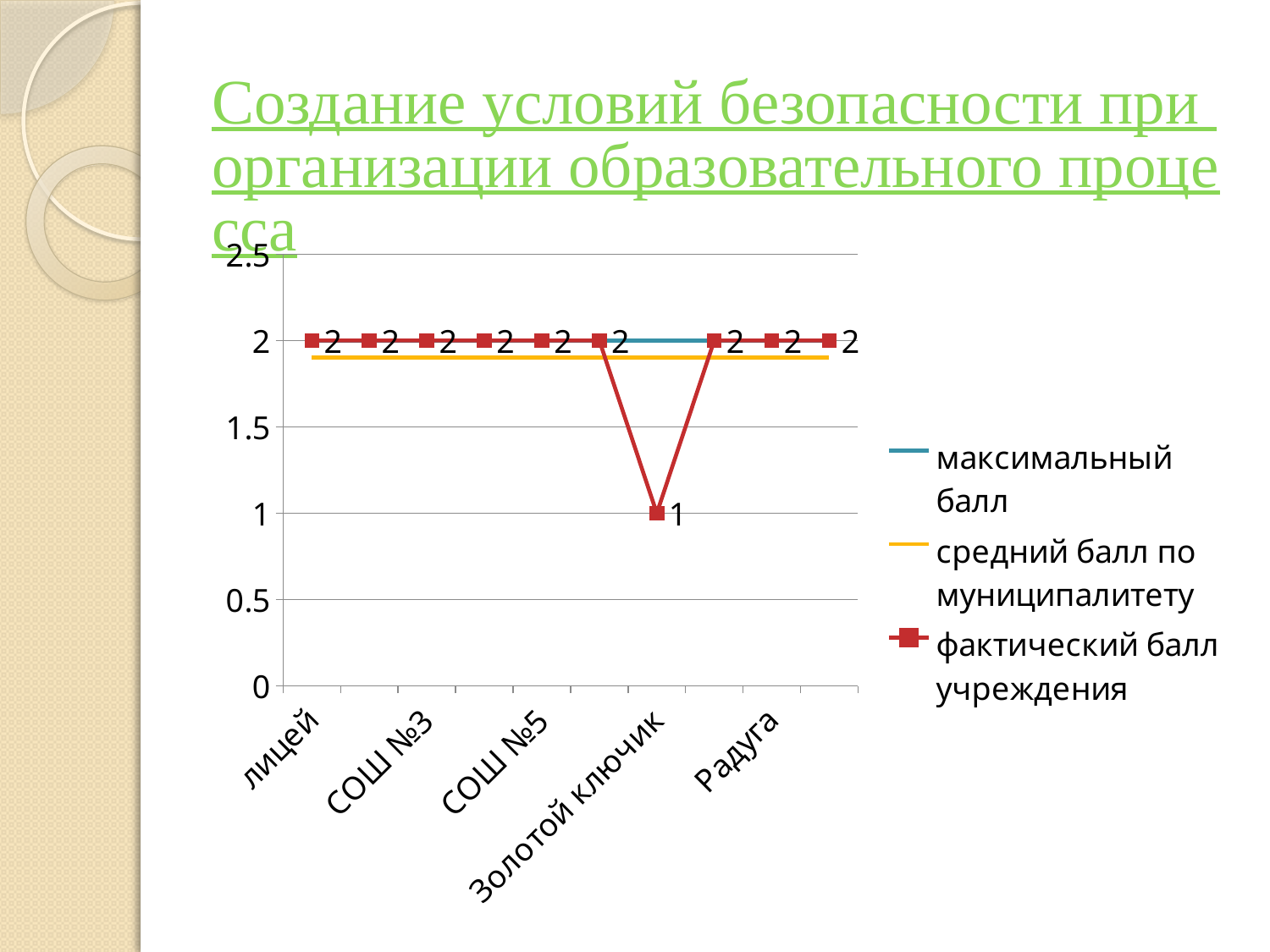
Which series is drawn in red with square markers? фактический балл учреждения Is the средний балл по муниципалитету line greater or less than 2? less Is the фактический балл учреждения for Золотой ключик greater or less than 1.5? less What is the фактический балл учреждения value for Радуга? 2 Which has the larger фактический балл учреждения, СОШ №3 or Золотой ключик? СОШ №3 What kind of chart is shown on the slide? line chart What is the фактический балл учреждения value for СОШ №5? 2 What is the фактический балл учреждения value for лицей? 2 How many series does the legend list? 3 What is the фактический балл учреждения value for Золотой ключик? 1 What is the difference between the фактический балл учреждения for лицей and for Золотой ключик? 1 Which labelled category has the lowest фактический балл учреждения? Золотой ключик